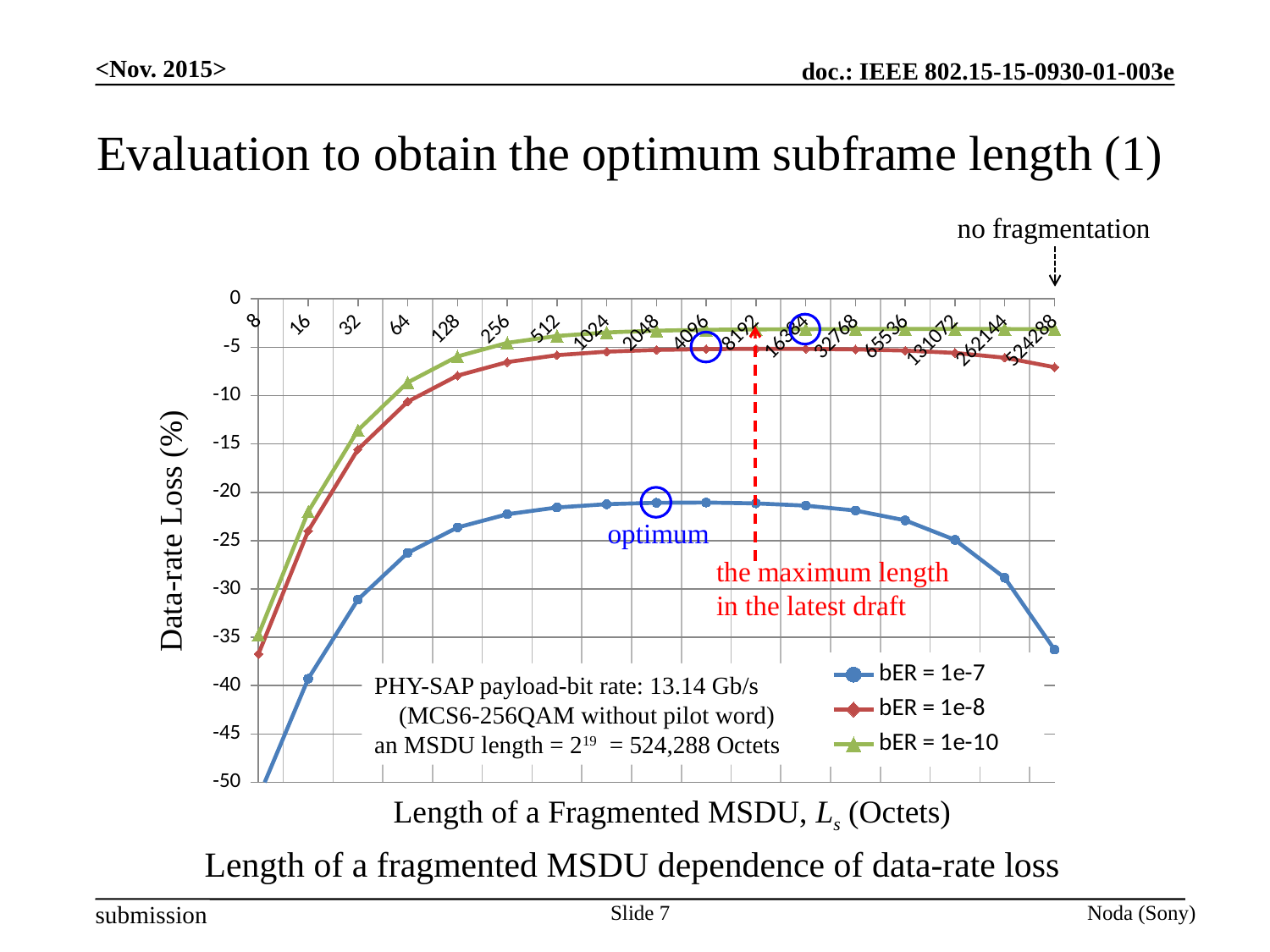
Is the value for bER = 1e-10 at 16 greater or less than -20? less Is the value for bER = 1e-8 at 524288 greater or less than -10? greater Which series is plotted with triangle markers? bER = 1e-10 Does the bER = 1e-10 series rise or fall from 8 to 512 along the x axis? rise What kind of chart is shown on the slide? line chart Is the value for bER = 1e-7 at 524288 greater or less than -30? less At 524288, which series has the higher value, bER = 1e-10 or bER = 1e-8? bER = 1e-10 How many series does the legend list? 3 How many points are marked along the x axis of the chart? 17 What is the title of the y axis? Data-rate Loss (%)